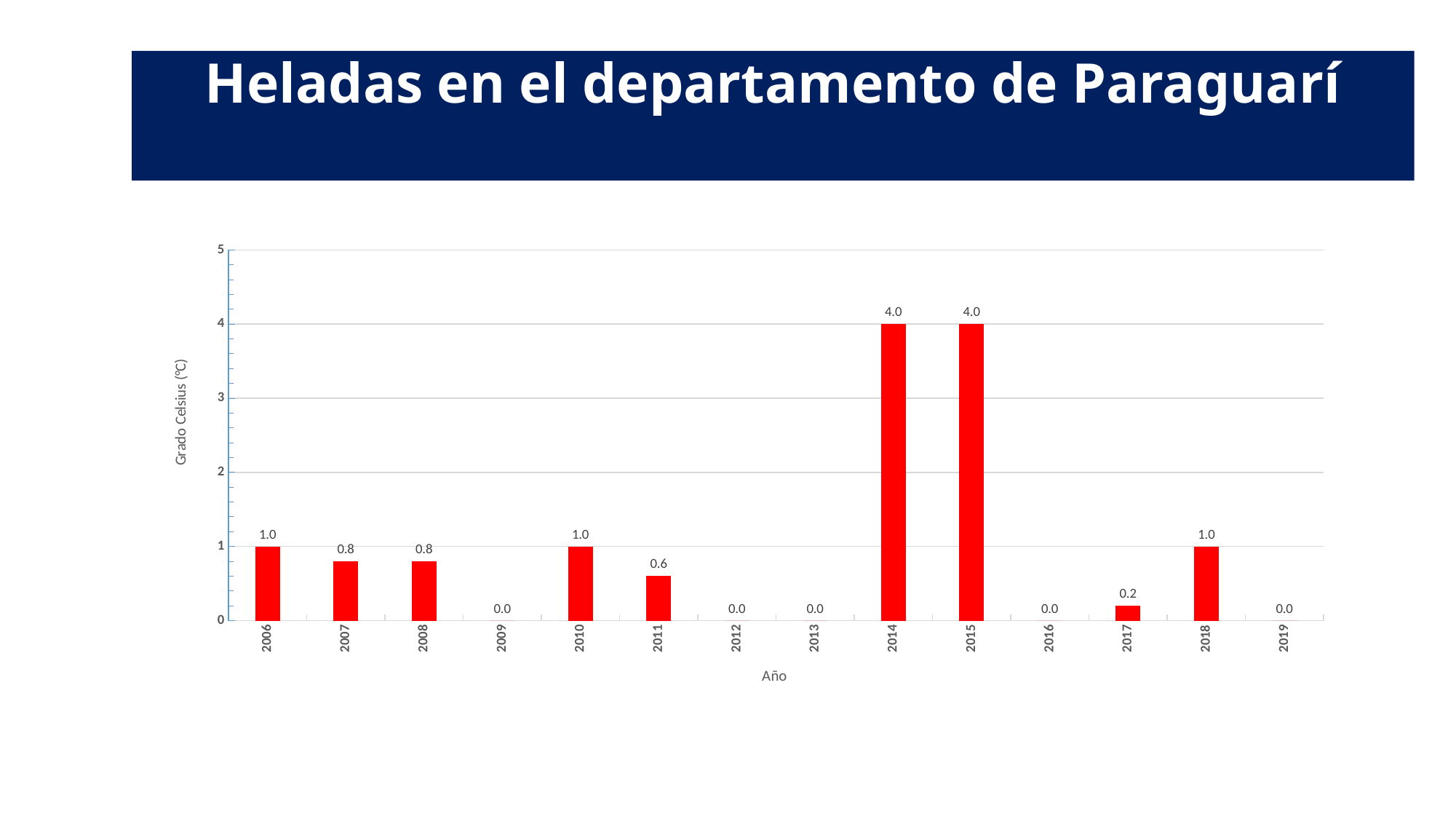
Which is larger, the value for 2008 or the value for 2010? 2010 What kind of chart is shown on the slide? Bar chart Is the value for 2014 greater or less than 3? greater What is the difference between the values for 2015 and 2018? 3.0 What is the value for 2007? 0.8 What is the value for 2014? 4.0 Which year has the lowest non-zero value? 2017 How many years are shown on the x axis? 14 What is the value for 2011? 0.6 What is the difference between the values for 2006 and 2011? 0.4 What is the value for 2017? 0.2 What is the label of the y axis? Grado Celsius (°C)